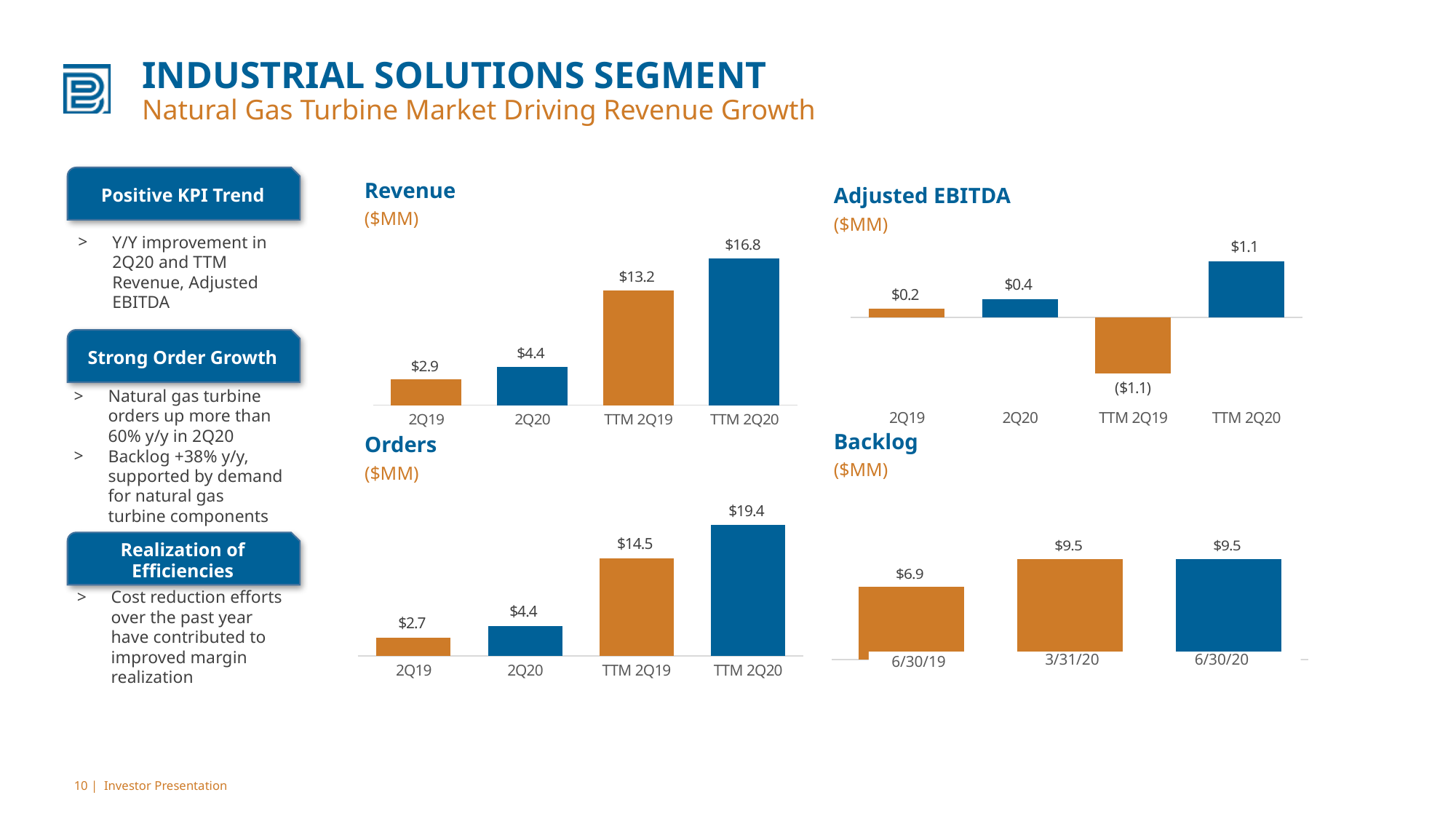
In the Adjusted EBITDA chart, which is larger, 2Q19 or 2Q20? 2Q20 In the Revenue chart, what is the difference between TTM 2Q20 and TTM 2Q19? $3.6 In the Orders chart, how many categories are shown on the x axis? 4 In the Orders chart, what is the value for 2Q19? $2.7 In the Backlog chart, what is the value for 6/30/19? $6.9 In the Adjusted EBITDA chart, which category has the highest value? TTM 2Q20 What kind of chart is the Backlog chart? Bar chart In the Revenue chart, what is the value for TTM 2Q20? $16.8 In the Backlog chart, how many categories are shown? 3 In the Adjusted EBITDA chart, what is the value for TTM 2Q19? ($1.1) In the Revenue chart, which category has the lowest value? 2Q19 In the Orders chart, what is the difference between 2Q20 and 2Q19? $1.7